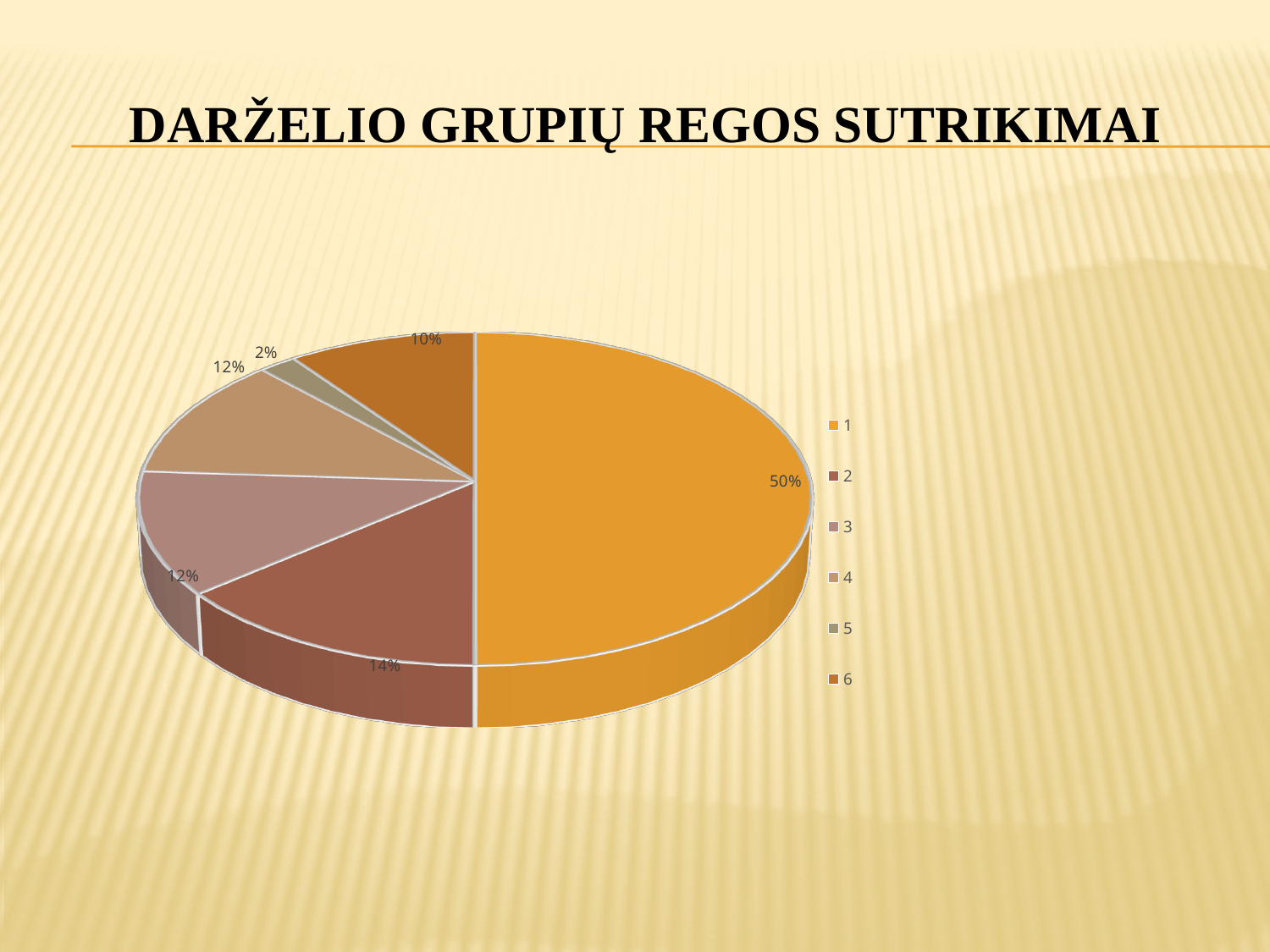
What is the title of the slide? DARŽELIO GRUPIŲ REGOS SUTRIKIMAI What is the difference between the share of category 1 and the share of category 2? 36% How many slices does the pie chart have? 6 What is the value shown for category 2? 14% What kind of chart is shown on the slide? pie chart Which category has the largest slice of the pie? 1 What share of the pie does category 1 have? 50% Which category has the smallest slice of the pie? 5 Which is larger, the share of category 2 or the share of category 6? category 2 What is the value shown for category 6? 10% How many entries does the legend list? 6 What is the value shown for category 5? 2%